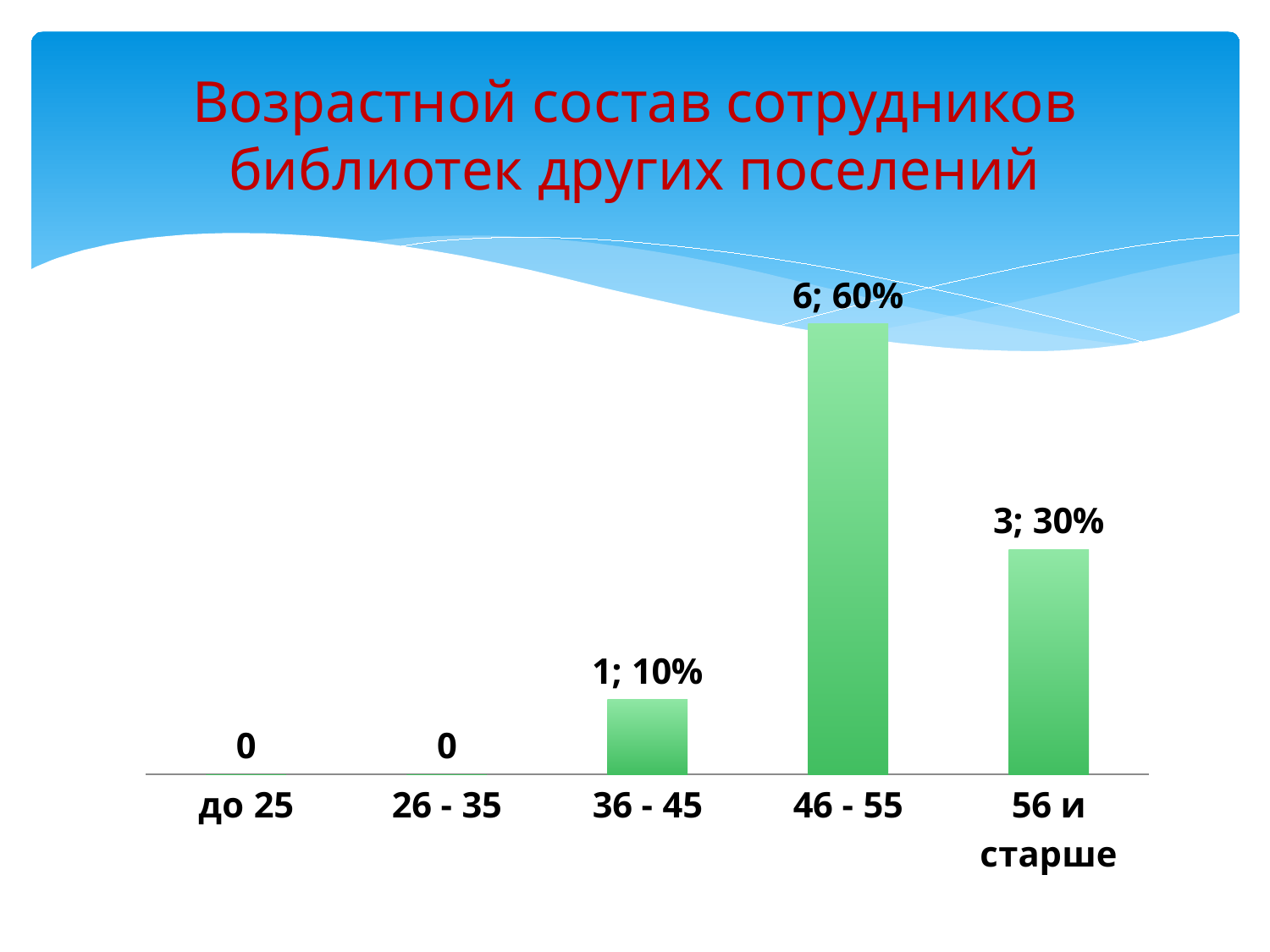
Which category has the highest value? 46 - 55 What is the title of the slide? Возрастной состав сотрудников библиотек других поселений What is the value for the 36 - 45 category? 1; 10% What is the difference in count between the 46 - 55 and 56 и старше categories? 3 What is the value for the 56 и старше category? 3; 30% How many categories are shown on the x axis? 5 What kind of chart is shown on the slide? Bar chart What is the total count across all categories? 10 What is the value for the до 25 category? 0 What is the value for the 46 - 55 category? 6; 60% Which is larger, the value for 36 - 45 or the value for 56 и старше? 56 и старше How many categories have a value of 0? 2